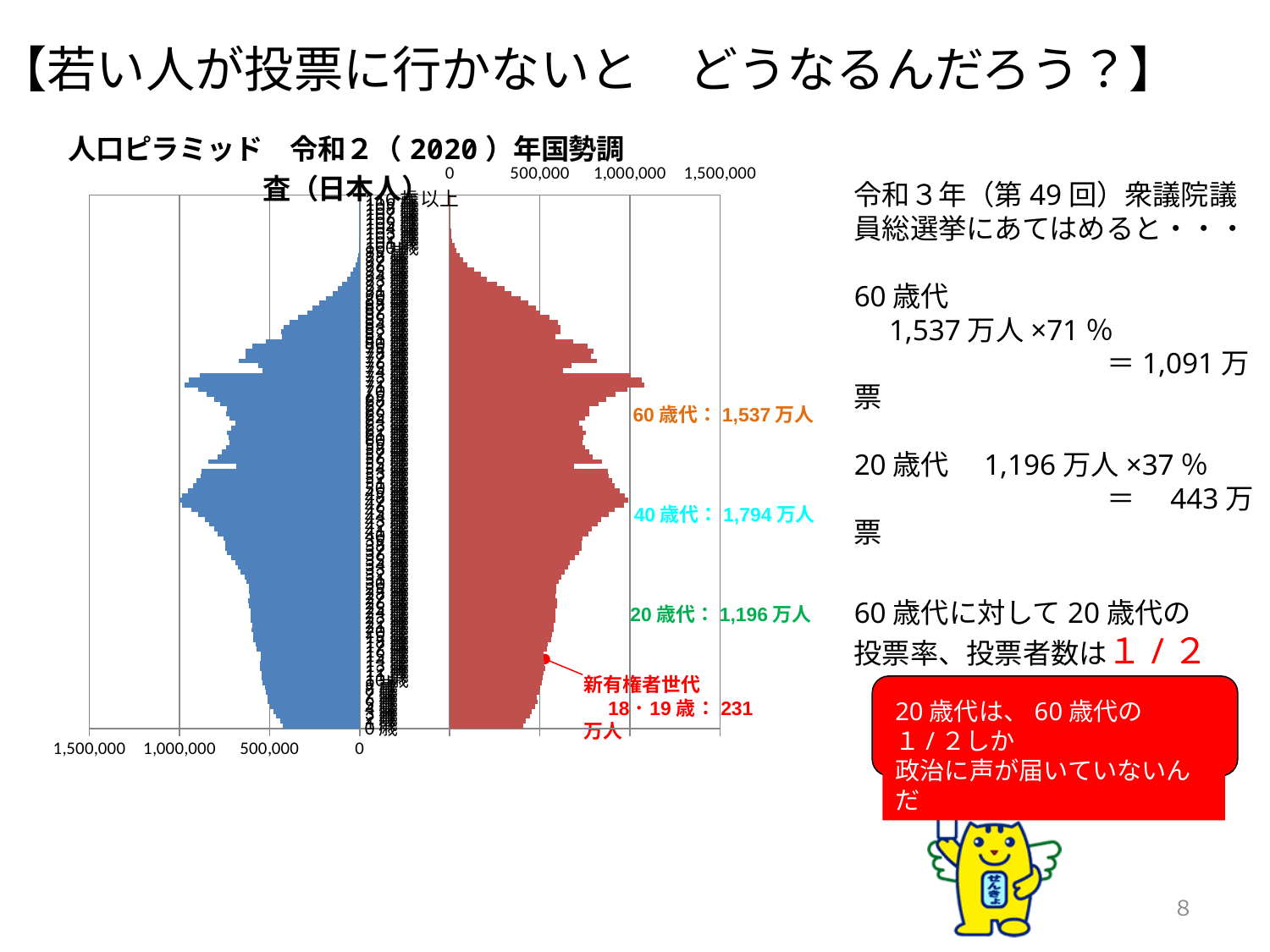
What is the difference between the annotated populations of the 60歳代 and 20歳代 groups? 341万人 Of the age groups annotated on the chart, which has the smallest population? 18・19歳 Of the age groups annotated on the chart, which has the largest population? 40歳代 Which annotated group has the larger population, 60歳代 or 20歳代? 60歳代 According to the annotation on the chart, what is the population of the 20歳代 group? 1,196万人 What is the difference between the annotated populations of the 40歳代 and 60歳代 groups? 257万人 What kind of chart is shown on the slide? Bar chart (population pyramid) Is the longest bar on the right (red) side of the pyramid greater or less than 1,500,000? less According to the annotation on the chart, what is the population of the 40歳代 group? 1,794万人 What is the title of the chart? 人口ピラミッド 令和２（2020）年国勢調査（日本人） According to the annotation on the chart, what is the population of the 60歳代 group? 1,537万人 According to the annotation on the chart, what is the population of the 新有権者世代 (18・19歳) group? 231万人